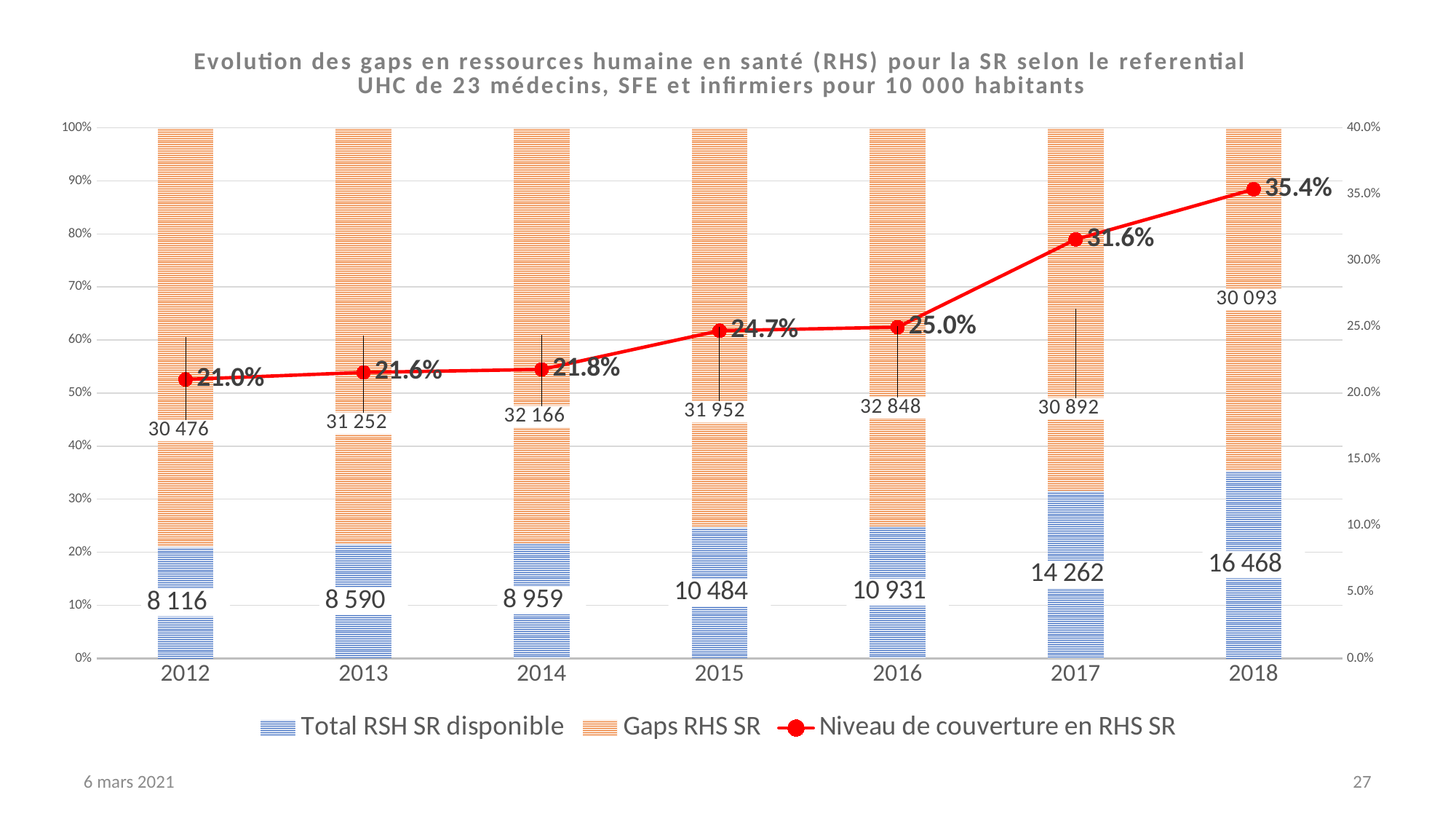
What is the value of Gaps RHS SR for 2014? 32 166 In which year is Gaps RHS SR highest? 2016 What is the difference between Total RSH SR disponible in 2018 and in 2012? 8 352 Which is larger, Gaps RHS SR in 2013 or in 2017? 2013 How many years are shown on the x axis? 7 Does the Niveau de couverture en RHS SR rise or fall from 2012 to 2018? Rise How many series does the legend list? 3 In which year is Total RSH SR disponible lowest? 2012 What is the total of Total RSH SR disponible and Gaps RHS SR for 2018? 46 561 What kind of chart is this? Stacked bar chart with a line What is the Niveau de couverture en RHS SR for 2017? 31.6% What is the value of Total RSH SR disponible for 2015? 10 484